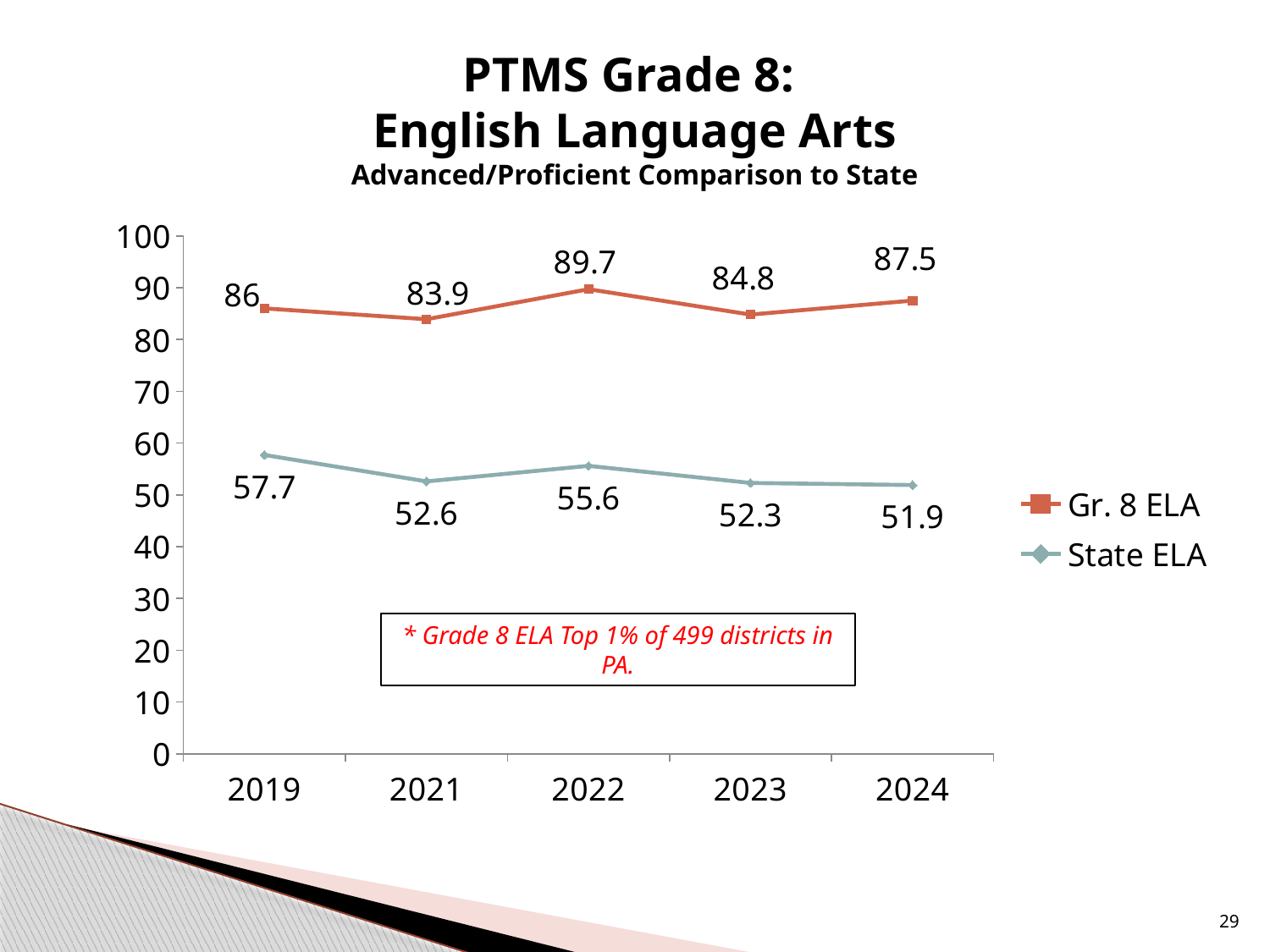
Does the State ELA value rise or fall from 2019 to 2021? Fall What is the difference between the Gr. 8 ELA and State ELA values in 2023? 32.5 In which year is the Gr. 8 ELA value highest? 2022 In which year is the State ELA value lowest? 2024 What is the Gr. 8 ELA value for 2024? 87.5 What kind of chart is shown on the slide? Line chart What are the two series named in the legend? Gr. 8 ELA and State ELA How many years are shown on the x axis? 5 Which is larger in 2021: the Gr. 8 ELA value or the State ELA value? Gr. 8 ELA What is the Gr. 8 ELA value for 2022? 89.7 What is the State ELA value for 2019? 57.7 How many series does the legend list? 2